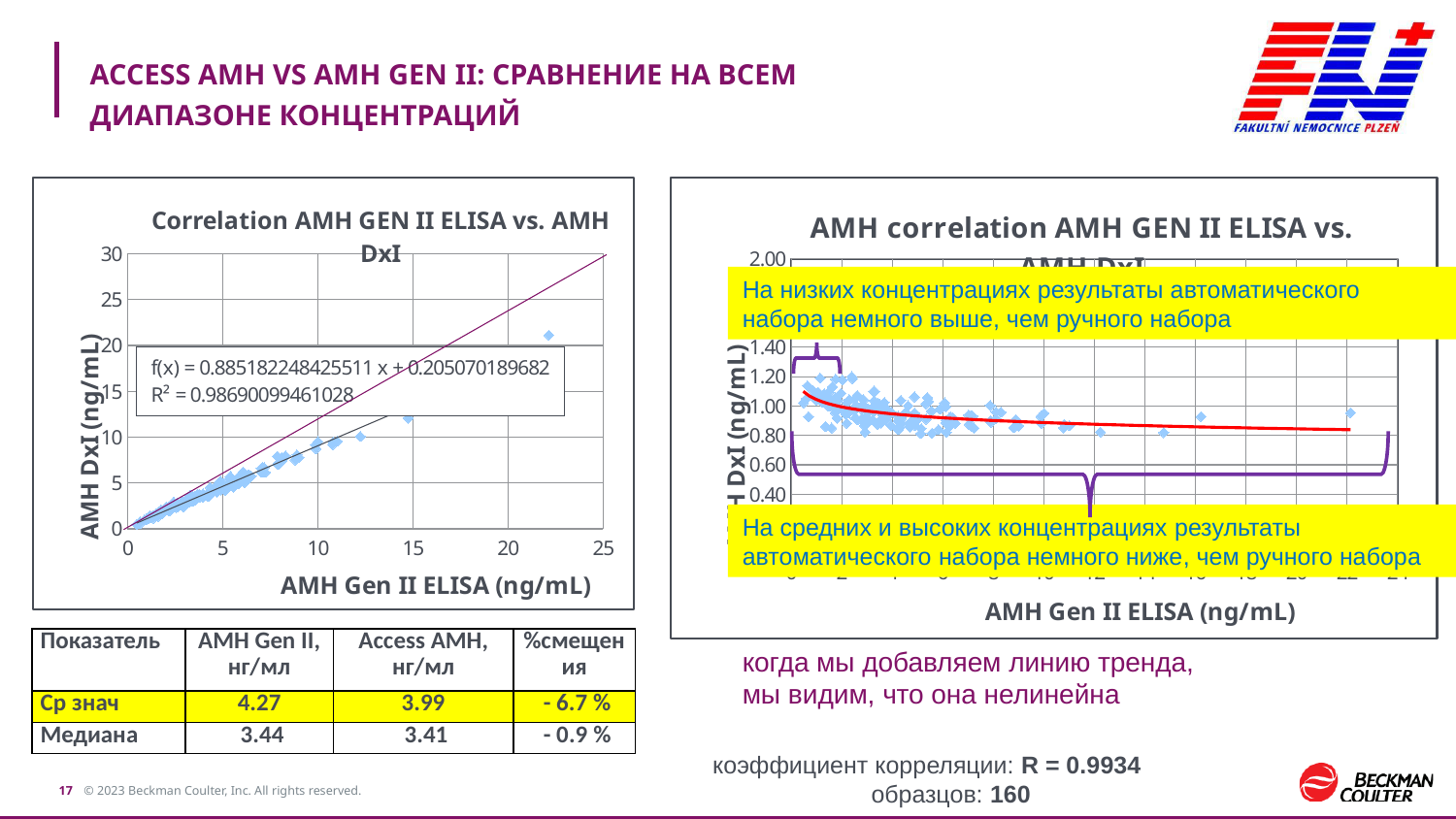
On the right chart, what is the highest value shown on the y axis? 2.00 On the right chart, does the red trend line rise or fall as the x-axis value increases? fall On the left chart, what is the label of the y axis? AMH DxI (ng/mL) On the left chart, what is the intercept of the fitted line f(x)? 0.205070189682 On the left chart, what is the slope of the fitted line f(x)? 0.885182248425511 On the left chart, what is the highest value shown on the y axis? 30 On the left chart, what is the label of the x axis? AMH Gen II ELISA (ng/mL) On the left chart, what is the R² value shown for the trend line? 0.98690099461028 What kind of chart is the right chart titled "AMH correlation AMH GEN II ELISA vs. AMH DxI"? scatter chart On the left chart, what is the highest value shown on the x axis? 25 What kind of chart is the left chart titled "Correlation AMH GEN II ELISA vs. AMH DxI"? scatter chart On the left chart, do the plotted points rise or fall as the x-axis value increases? rise